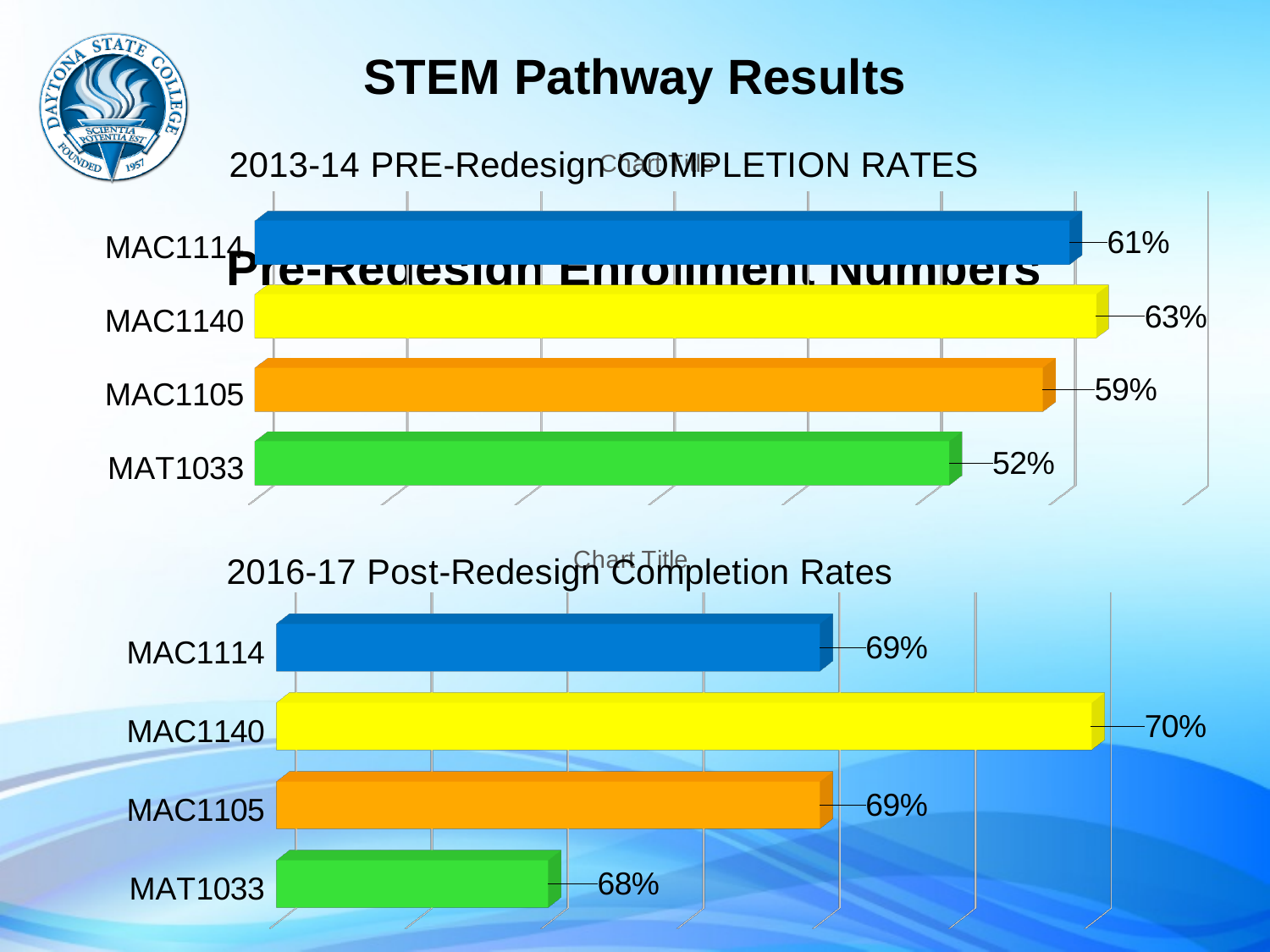
In the 2016-17 Post-Redesign Completion Rates chart, which course has the lowest completion rate? MAT1033 In the 2016-17 Post-Redesign Completion Rates chart, what is the completion rate for MAT1033? 68% How many courses are shown in the 2016-17 Post-Redesign Completion Rates chart? 4 In the 2013-14 PRE-Redesign COMPLETION RATES chart, what is the completion rate for MAC1140? 63% In the 2013-14 PRE-Redesign COMPLETION RATES chart, which course has the lowest completion rate? MAT1033 In the 2016-17 Post-Redesign Completion Rates chart, what is the completion rate for MAC1140? 70% In the 2016-17 Post-Redesign Completion Rates chart, which course has the highest completion rate? MAC1140 In the 2013-14 PRE-Redesign COMPLETION RATES chart, what is the difference between the completion rates of MAC1114 and MAT1033? 9% In the 2013-14 PRE-Redesign COMPLETION RATES chart, which is larger, the completion rate for MAC1105 or for MAT1033? MAC1105 In the 2013-14 PRE-Redesign COMPLETION RATES chart, what is the completion rate for MAT1033? 52% In the 2013-14 PRE-Redesign COMPLETION RATES chart, which course has the highest completion rate? MAC1140 What type of chart is the 2013-14 PRE-Redesign COMPLETION RATES chart? Bar chart